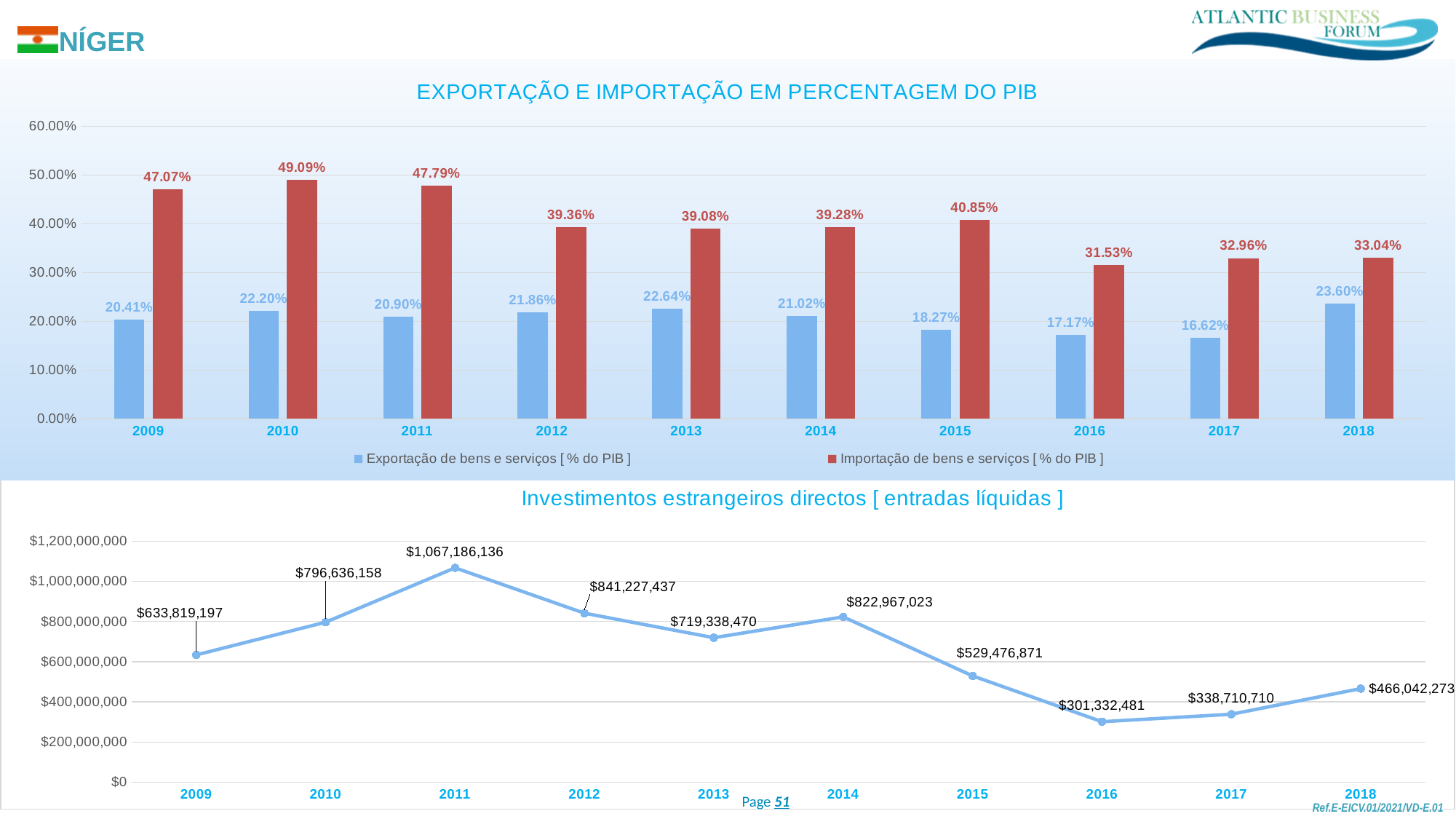
In the chart 'EXPORTAÇÃO E IMPORTAÇÃO EM PERCENTAGEM DO PIB', what is the difference between Importação and Exportação in 2018? 9.44% What kind of chart is 'EXPORTAÇÃO E IMPORTAÇÃO EM PERCENTAGEM DO PIB'? Bar chart In the chart 'Investimentos estrangeiros directos [ entradas líquidas ]', which year has the lowest value? 2016 In the chart 'EXPORTAÇÃO E IMPORTAÇÃO EM PERCENTAGEM DO PIB', which year has the lowest Exportação de bens e serviços value? 2017 In the chart 'Investimentos estrangeiros directos [ entradas líquidas ]', what is the value for 2014? $822,967,023 In the chart 'EXPORTAÇÃO E IMPORTAÇÃO EM PERCENTAGEM DO PIB', what is the value of Importação de bens e serviços in 2010? 49.09% In the chart 'Investimentos estrangeiros directos [ entradas líquidas ]', which year has the highest value? 2011 In the chart 'Investimentos estrangeiros directos [ entradas líquidas ]', how many years are plotted? 10 In the chart 'EXPORTAÇÃO E IMPORTAÇÃO EM PERCENTAGEM DO PIB', what is the value of Exportação de bens e serviços in 2017? 16.62% In the chart 'EXPORTAÇÃO E IMPORTAÇÃO EM PERCENTAGEM DO PIB', which year has the highest Importação de bens e serviços value? 2010 In the chart 'EXPORTAÇÃO E IMPORTAÇÃO EM PERCENTAGEM DO PIB', how many series does the legend list? 2 In the chart 'Investimentos estrangeiros directos [ entradas líquidas ]', what is the difference between the 2011 and 2016 values? $765,853,655